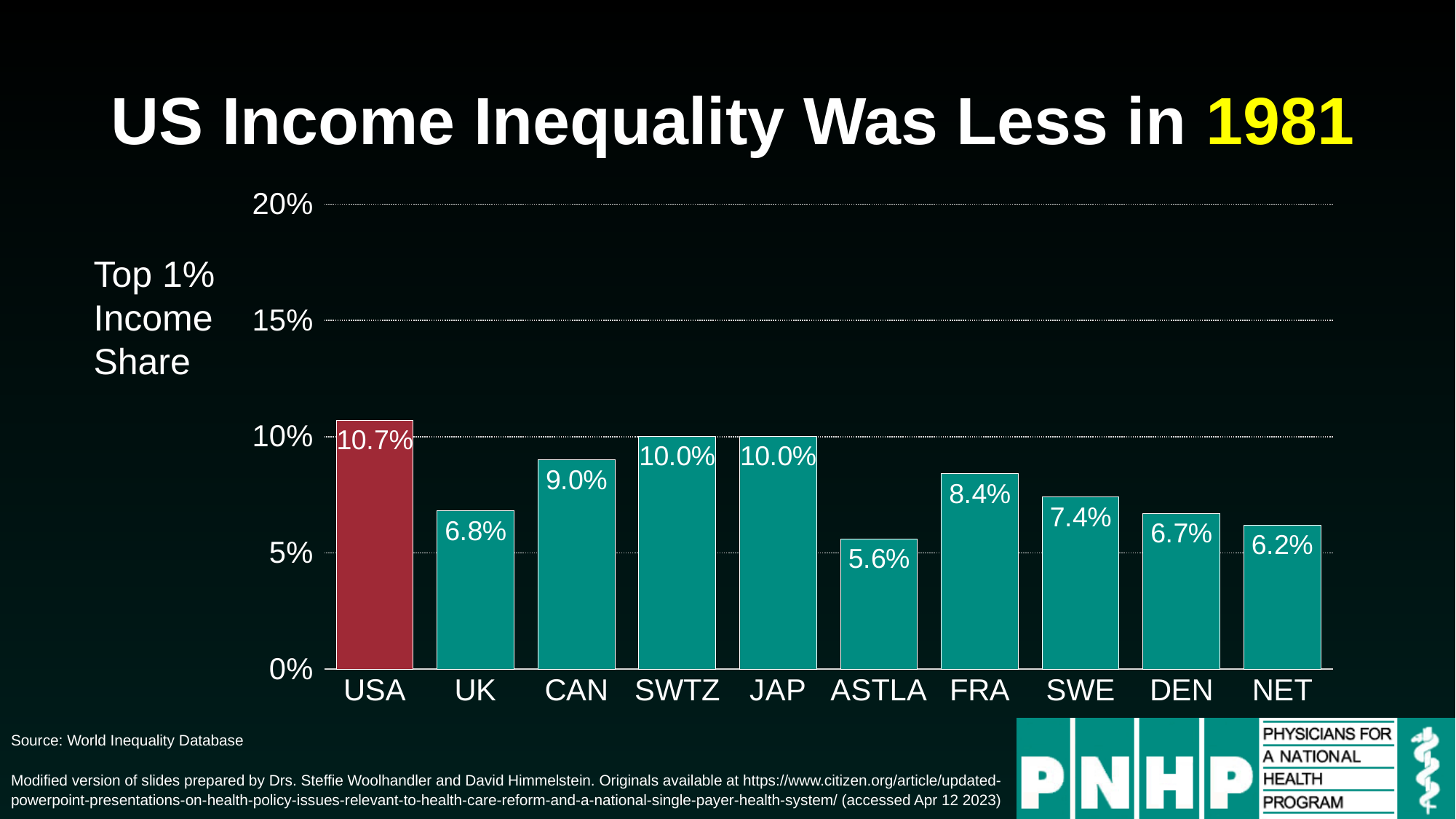
What kind of chart is shown on the slide? bar chart Which has a larger top 1% income share, CAN or SWE? CAN Which bar is coloured differently (red) from the others? USA Is the value for DEN greater or less than 10%? less Which country has the highest top 1% income share? USA What is the difference between the top 1% income share of the USA and the UK? 3.9% What is the top 1% income share for ASTLA? 5.6% How many countries are shown on the chart? 10 What is the top 1% income share for FRA? 8.4% Which two countries have the same top 1% income share of 10.0%? SWTZ and JAP What is the top 1% income share for the USA? 10.7% Which country has the lowest top 1% income share? ASTLA